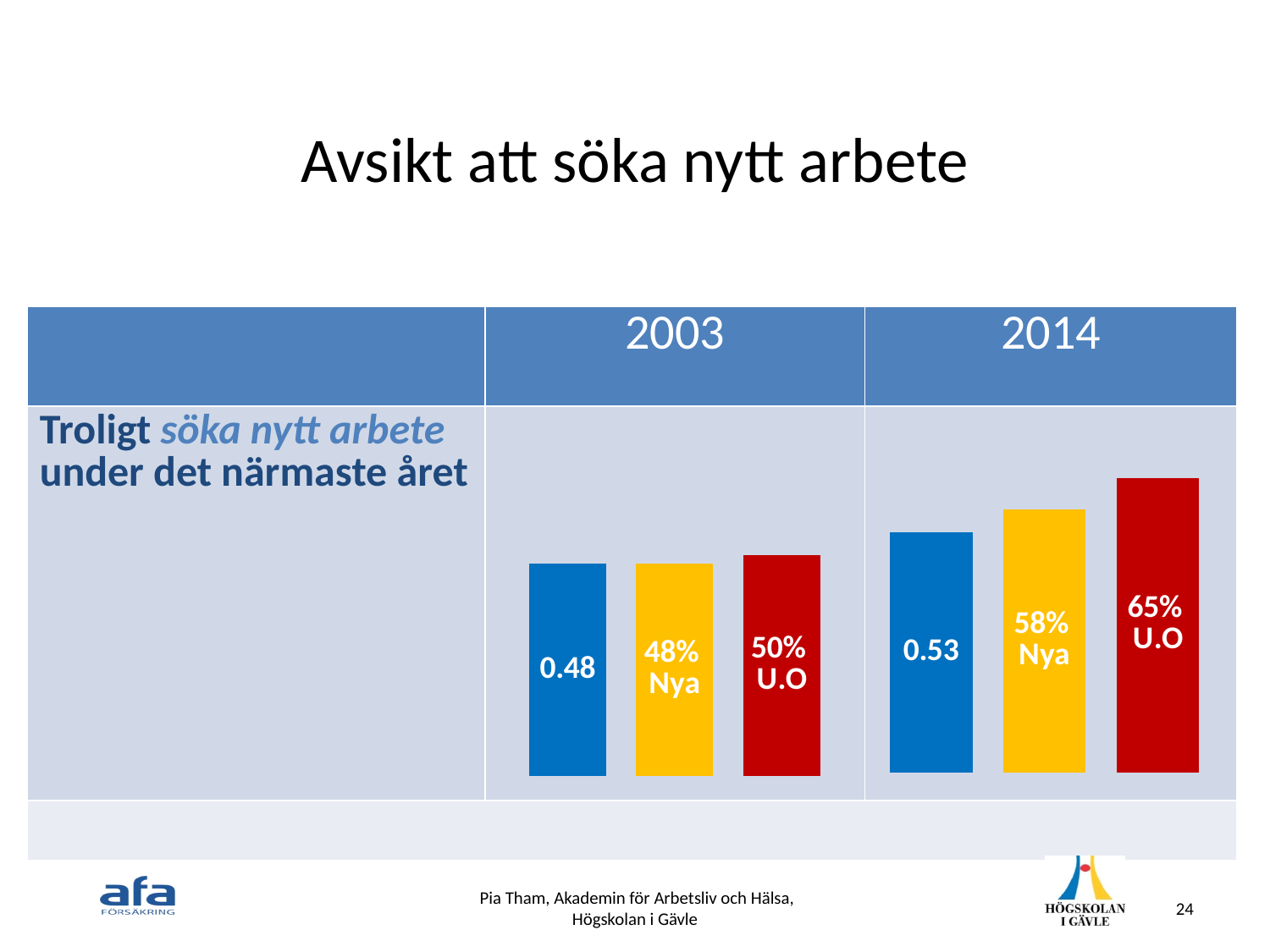
What is the value for Nya in 2003? 48% What is the value for Nya in 2014? 58% By how many percentage points did U.O increase from 2003 to 2014? 15 percentage points What kind of chart is shown on the slide? Bar chart Which bar is the highest in the 2014 group? U.O By how many percentage points did Nya increase from 2003 to 2014? 10 percentage points What is the value for U.O in 2014? 65% What value is printed on the blue bar for 2003? 0.48 In 2003, which is larger, Nya or U.O? U.O Which bar is the highest in the 2003 group? U.O How many bars are shown for the year 2014? 3 What value is printed on the blue bar for 2014? 0.53